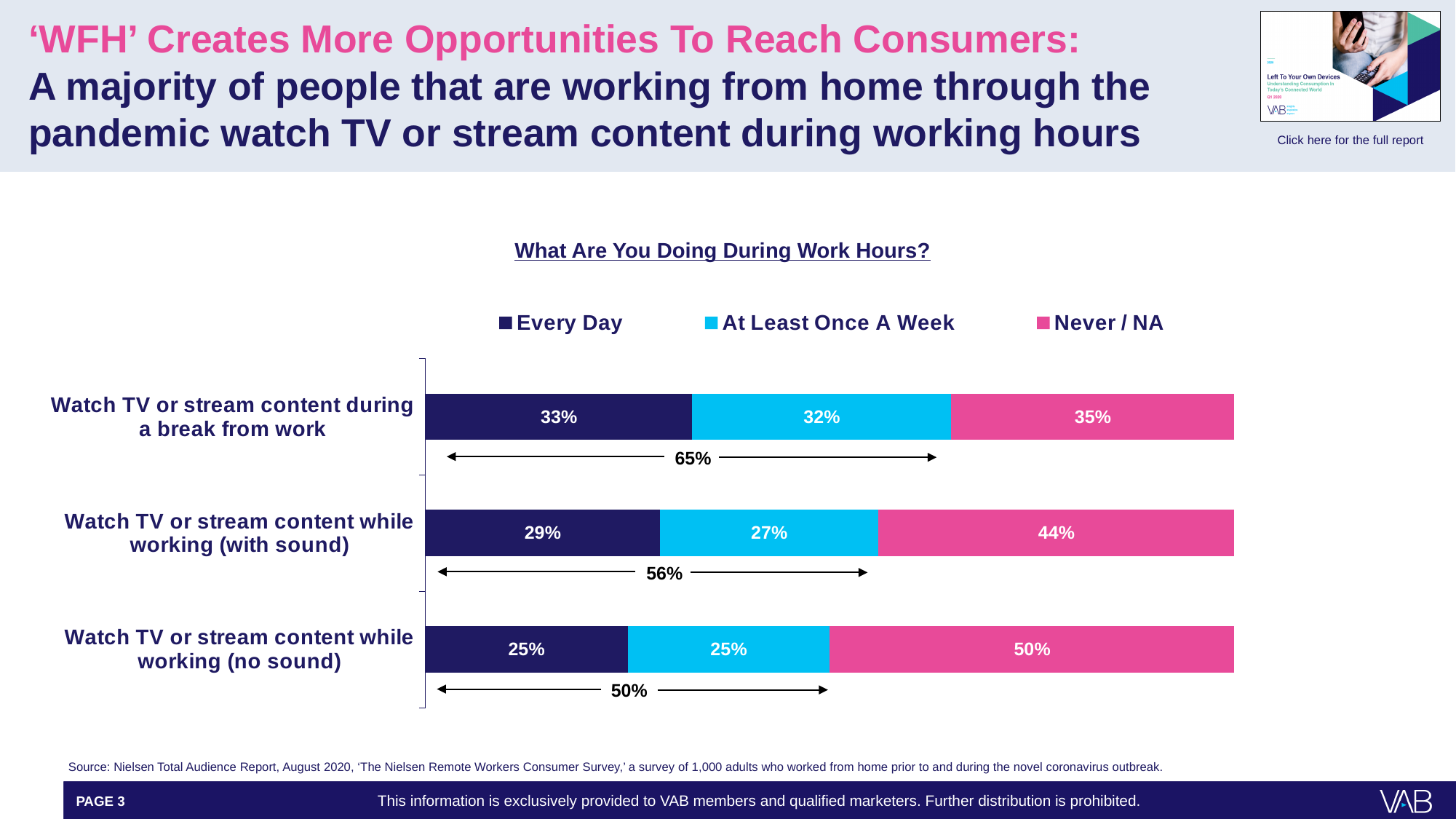
What percentage of respondents watch TV or stream content during a break from work every day? 33% What is the difference between the 'Never / NA' values for working (no sound) and during a break from work? 15% How many series does the legend list? 3 How many activity categories are shown in the chart? 3 What kind of chart is shown on the slide? Stacked bar chart What is the combined 'Every Day' and 'At Least Once A Week' total for watching TV or streaming content while working (with sound)? 56% What is the 'Never / NA' value for watching TV or streaming content while working (no sound)? 50% What is the 'At Least Once A Week' value for watching TV or streaming content while working (with sound)? 27% What is the title of the chart? What Are You Doing During Work Hours? Which is larger: the 'Every Day' value for working (with sound) or for working (no sound)? Working (with sound) Which activity has the highest 'Every Day' percentage? Watch TV or stream content during a break from work Which activity has the lowest 'Never / NA' percentage? Watch TV or stream content during a break from work